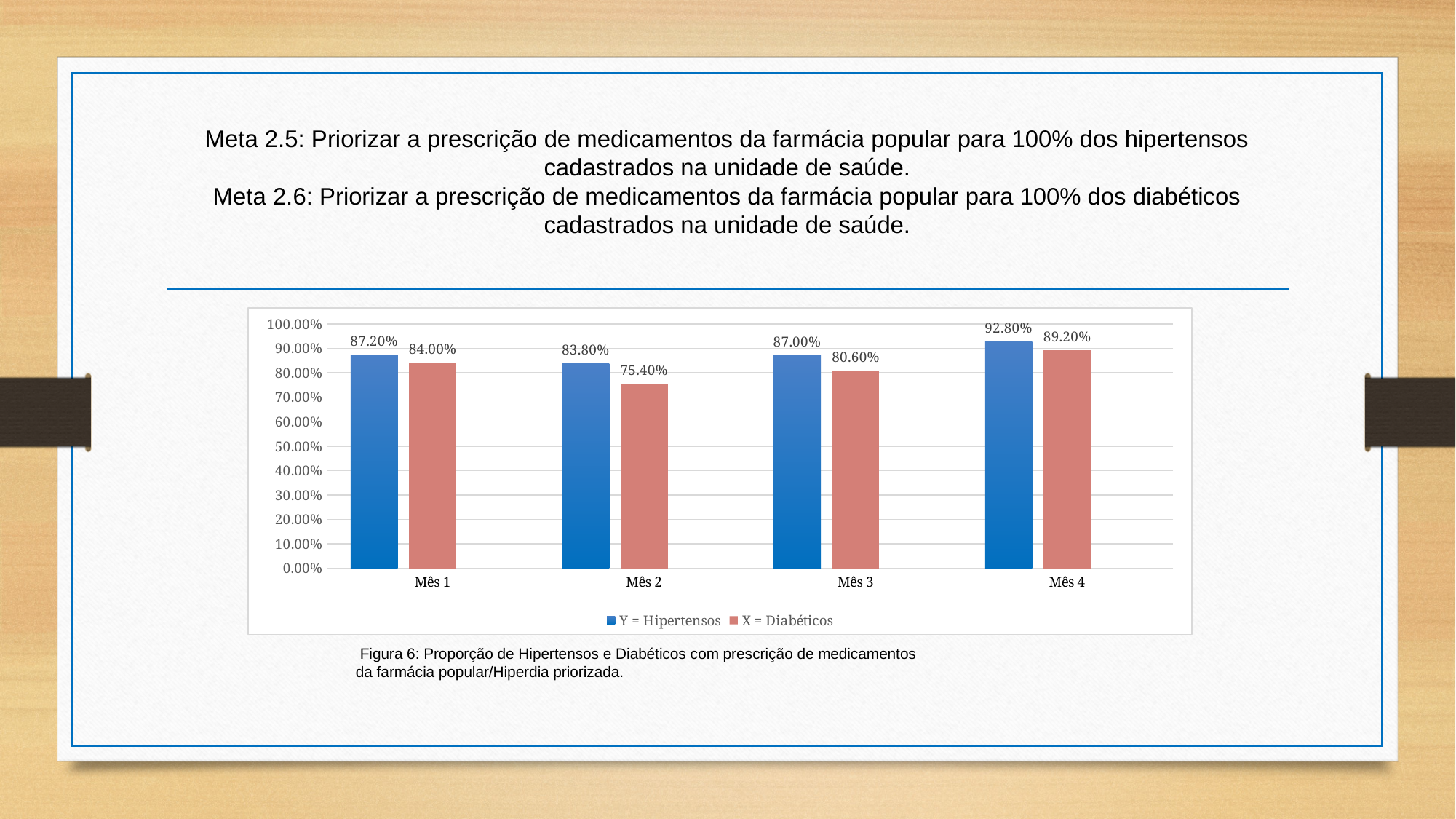
What is the value for X = Diabéticos in Mês 4? 89.20% What is the value for X = Diabéticos in Mês 2? 75.40% What kind of chart is shown on the slide? bar chart How many months are shown on the x axis? 4 Which is larger in Mês 3: Y = Hipertensos or X = Diabéticos? Y = Hipertensos How many series does the legend list? 2 What is the difference between Y = Hipertensos and X = Diabéticos in Mês 2? 8.40% Is the value for X = Diabéticos in Mês 3 greater or less than 90.00%? less In which month is the value for Y = Hipertensos highest? Mês 4 Which colour represents X = Diabéticos in the chart? red In which month is the value for X = Diabéticos lowest? Mês 2 What is the value for Y = Hipertensos in Mês 1? 87.20%